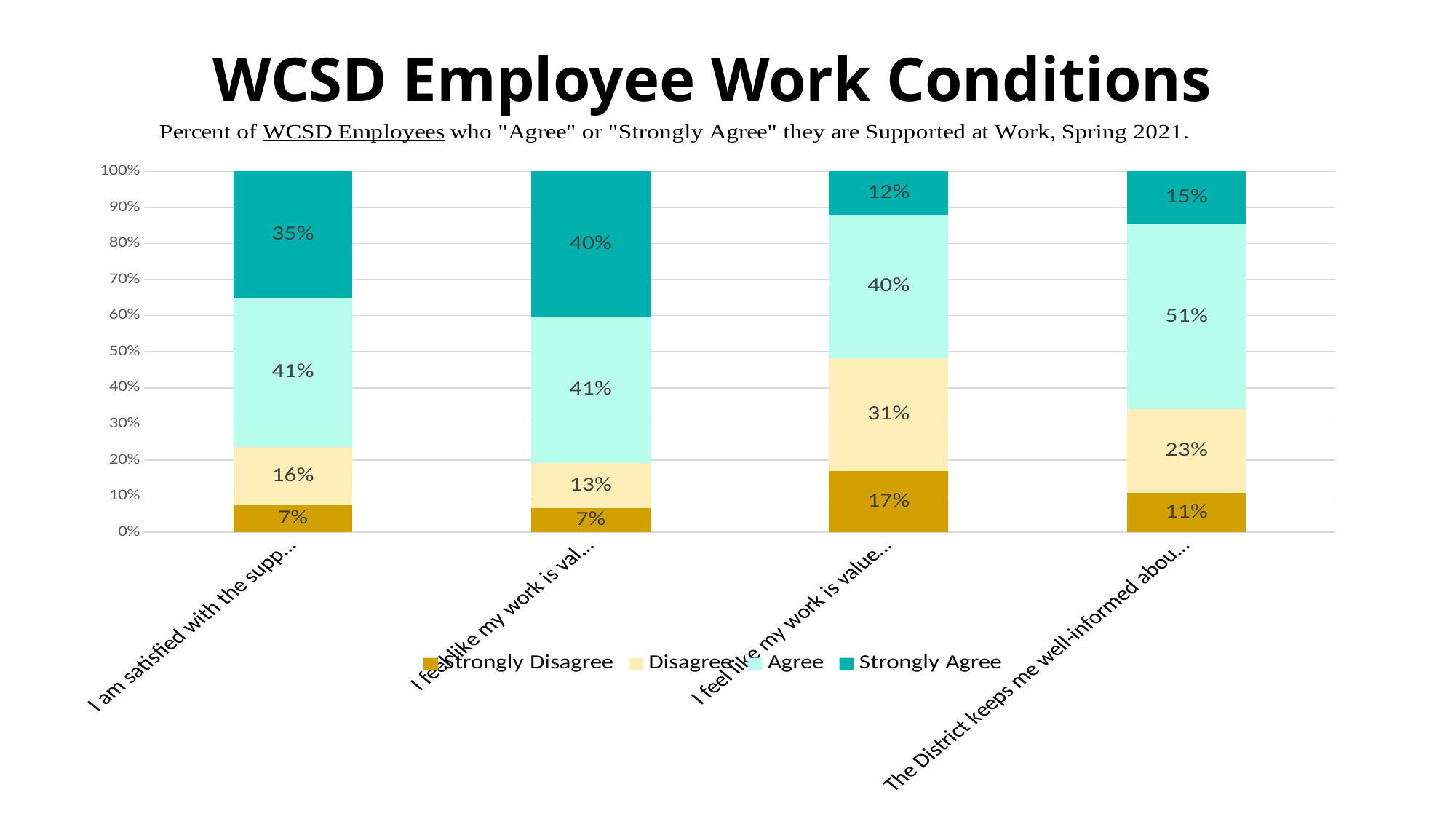
For the second bar from the left, what is the combined percentage of Agree and Strongly Agree? 81% Which bar has the highest Strongly Agree percentage? The second bar ("I feel like my work is val..."), 40% Which bar has the lowest Strongly Agree percentage? The third bar, 12% Which legend entry is shown in the darkest teal colour? Strongly Agree What is the Agree percentage for the bar labelled "The District keeps me well-informed abou..."? 51% How many survey statements (bars) are plotted in the chart? 4 How many series does the legend list? 4 What kind of chart is shown on the slide? Stacked bar chart In the bar for "The District keeps me well-informed abou...", how much larger is the Agree share than the Strongly Agree share? 36 percentage points What is the Strongly Disagree percentage for the third bar from the left? 17% What is the Strongly Agree percentage for the first bar ("I am satisfied with the supp...")? 35% Which has the larger Disagree percentage: the third bar or the fourth bar ("The District keeps me well-informed abou...")? The third bar (31%)